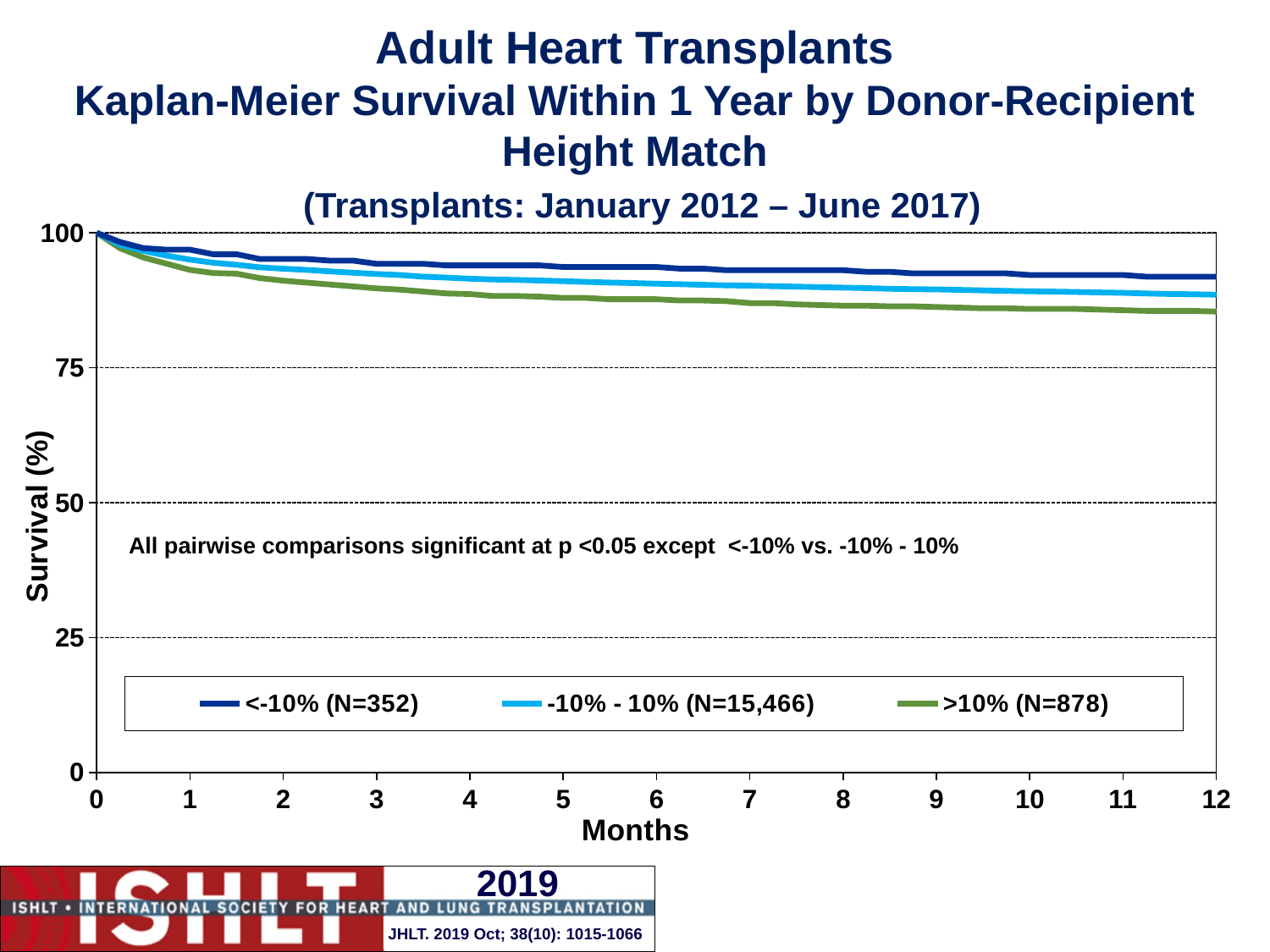
Which series has the highest survival at 12 months? <-10% (N=352) Which series has the lowest survival at 12 months? >10% (N=878) Is the survival value for the <-10% series at 12 months greater or less than 100? less At 12 months, which series has higher survival: -10% - 10% or >10%? -10% - 10% What is the label of the y axis? Survival (%) Do the survival curves rise or fall as months increase? fall At 6 months, which series has higher survival: <-10% or >10%? <-10% How many month tick marks are labelled on the x axis? 13 What kind of chart is shown on the slide? line chart Is the survival value for the >10% series at 12 months greater or less than 75? greater How many series does the legend list? 3 What is the N for the -10% - 10% series shown in the legend? 15,466